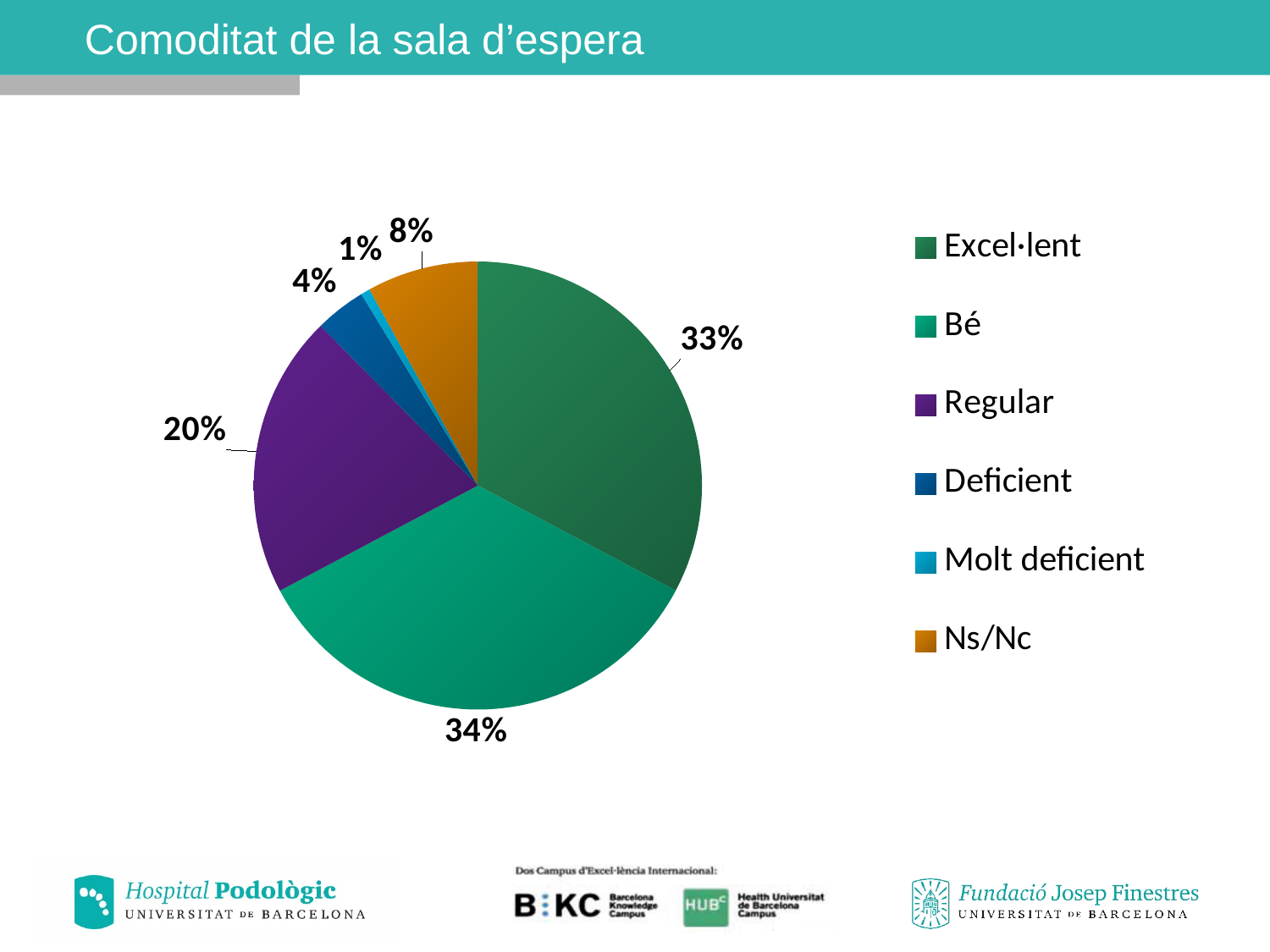
What share of the pie does Regular have? 20% Which category has the largest slice of the pie? Bé Which category has the smallest slice of the pie? Molt deficient What share of the pie does Bé have? 34% What kind of chart is shown on the slide? pie chart How many categories does the legend list? 6 What is the difference between the shares of Regular and Ns/Nc? 12% Which is larger, the share for Deficient or the share for Ns/Nc? Ns/Nc What share of the pie does Deficient have? 4% What is the title of the slide containing the chart? Comoditat de la sala d'espera